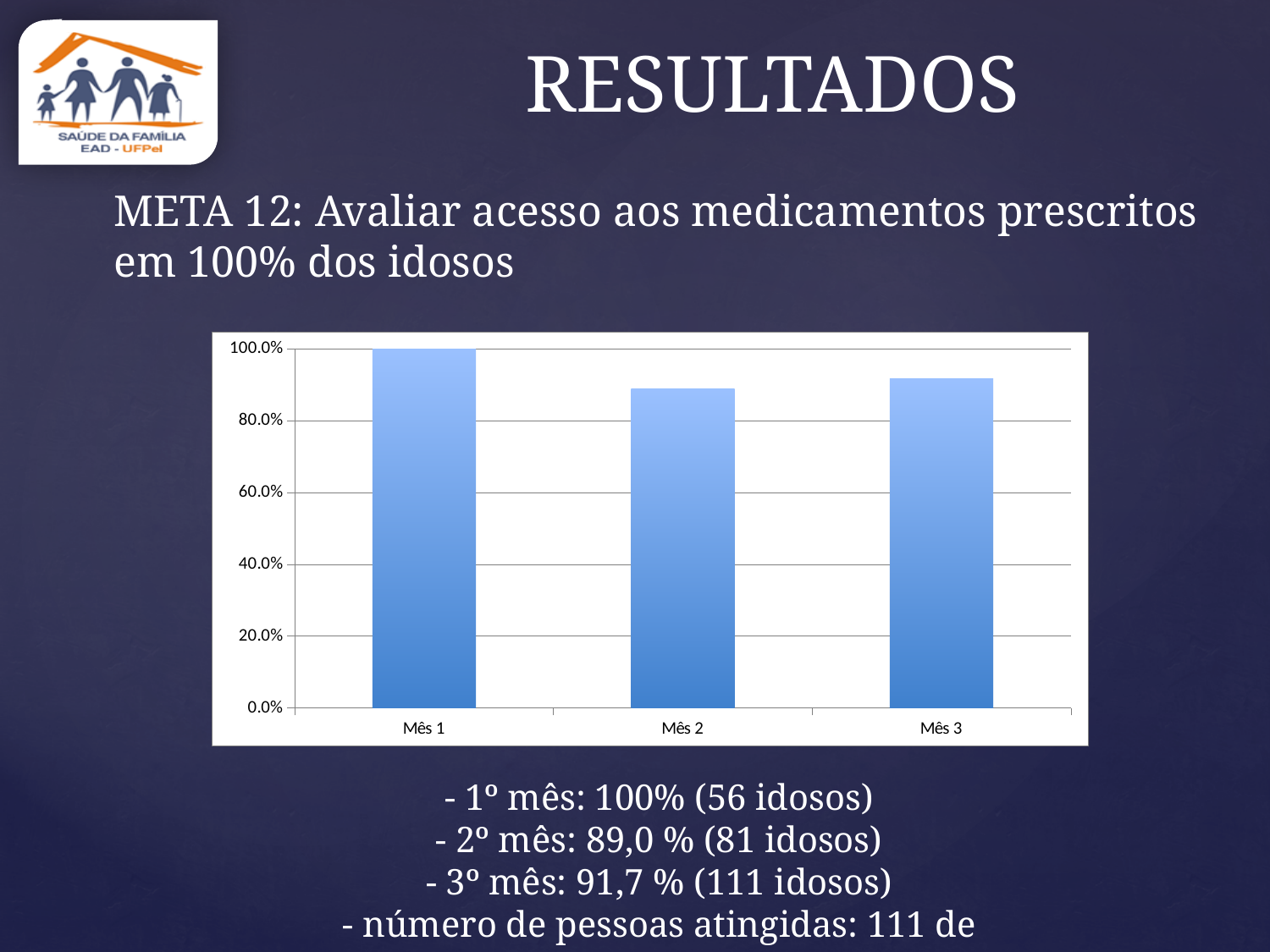
What is the value for Mês 1 in the chart? 100.0% Which month has the lowest value in the chart? Mês 2 What is the label of the first category on the horizontal axis? Mês 1 Is the value for Mês 2 greater or less than 80.0%? greater Which month has the highest value in the chart? Mês 1 Which is larger, the value for Mês 1 or the value for Mês 2? Mês 1 Is the value for Mês 3 greater or less than 80.0%? greater What is the highest tick value shown on the vertical axis of the chart? 100.0% How many categories (months) are plotted in the chart? 3 What type of chart is shown on the slide? bar chart Which is larger, the value for Mês 2 or the value for Mês 3? Mês 3 Is the value for Mês 2 greater or less than 100.0%? less